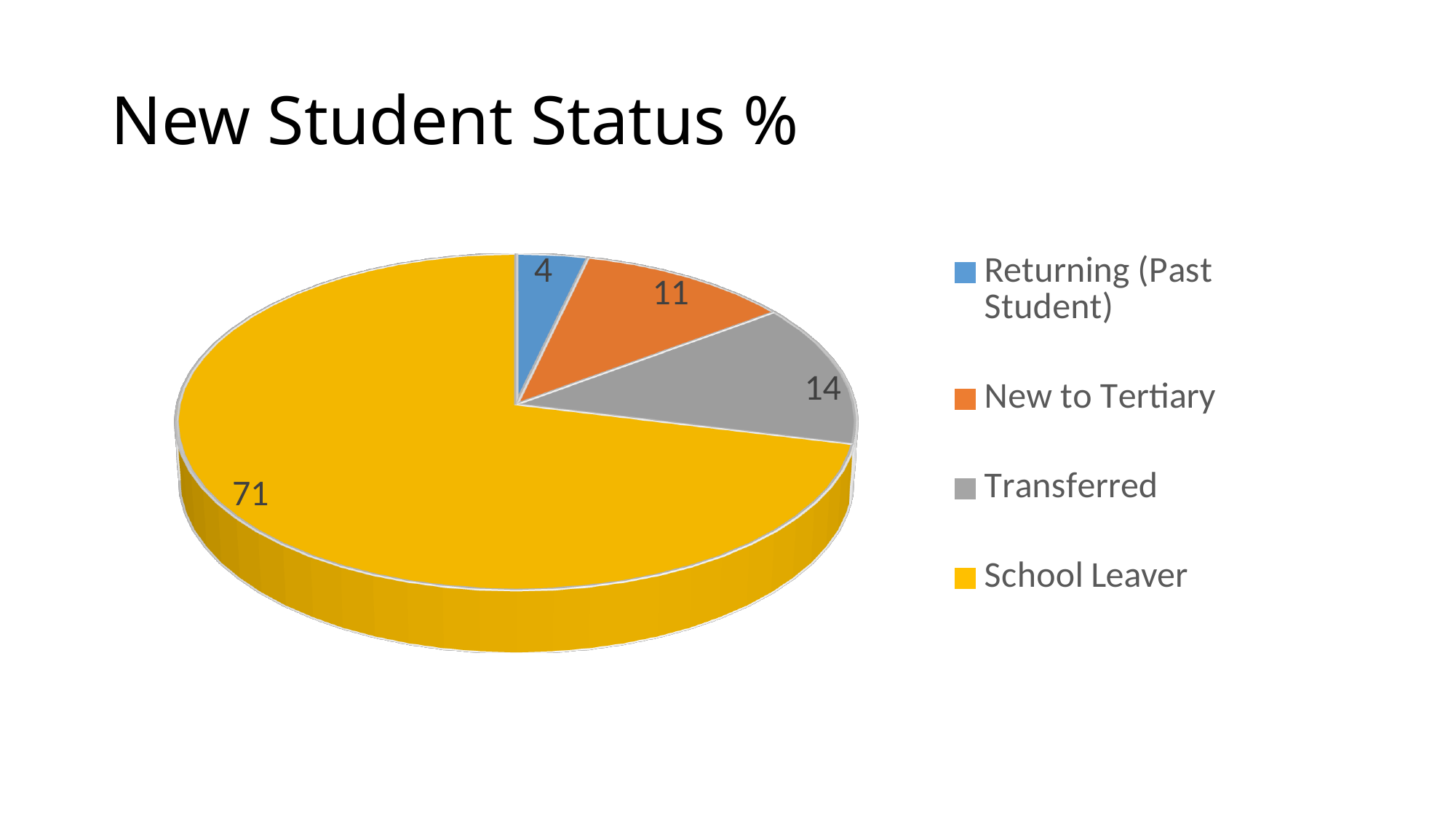
What colour is the School Leaver slice? Yellow Which category has the largest slice? School Leaver What is the title of the slide? New Student Status % What is the value for Returning (Past Student)? 4 What is the value for Transferred? 14 What kind of chart is shown on the slide? Pie chart Which category has the smallest slice? Returning (Past Student) How many categories does the pie chart have? 4 What is the difference between the values for Transferred and New to Tertiary? 3 What is the value for New to Tertiary? 11 Which is larger, the value for New to Tertiary or the value for Returning (Past Student)? New to Tertiary What is the value for School Leaver? 71